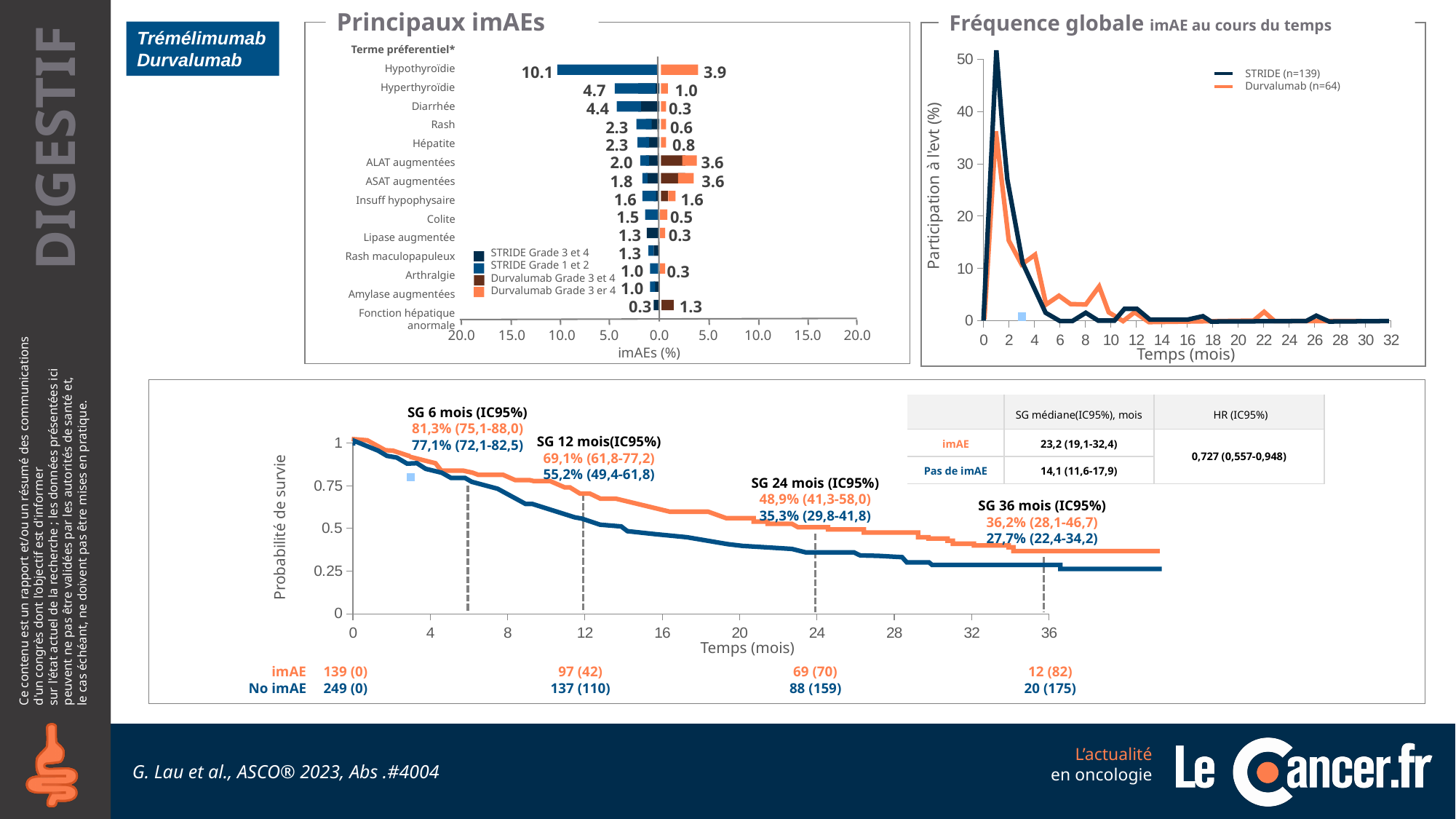
In the 'Principaux imAEs' chart, what is the Durvalumab value for ALAT augmentées? 3.6 In the 'Principaux imAEs' chart, how many entries does the legend list? 4 In the 'Principaux imAEs' chart, how many preferred terms are listed on the vertical axis? 14 In the 'Fréquence globale imAE au cours du temps' chart, how many series does the legend list? 2 In the 'Principaux imAEs' chart, what is the STRIDE value for Hypothyroïdie? 10.1 In the survival chart at the bottom, what is the SG 24 mois value for the imAE group? 48,9% (41,3-58,0) In the survival chart at the bottom, what is the HR (IC95%) shown in the table? 0,727 (0,557-0,948) In the 'Principaux imAEs' chart, which preferred term has the highest STRIDE value? Hypothyroïdie In the 'Fréquence globale imAE au cours du temps' chart, is the peak value of the STRIDE line greater or less than 40? greater In the 'Principaux imAEs' chart, which is larger for ASAT augmentées: the STRIDE value or the Durvalumab value? Durvalumab What kind of chart is 'Fréquence globale imAE au cours du temps'? Line chart In the 'Principaux imAEs' chart, what is the difference between the STRIDE and Durvalumab values for Hypothyroïdie? 6.2